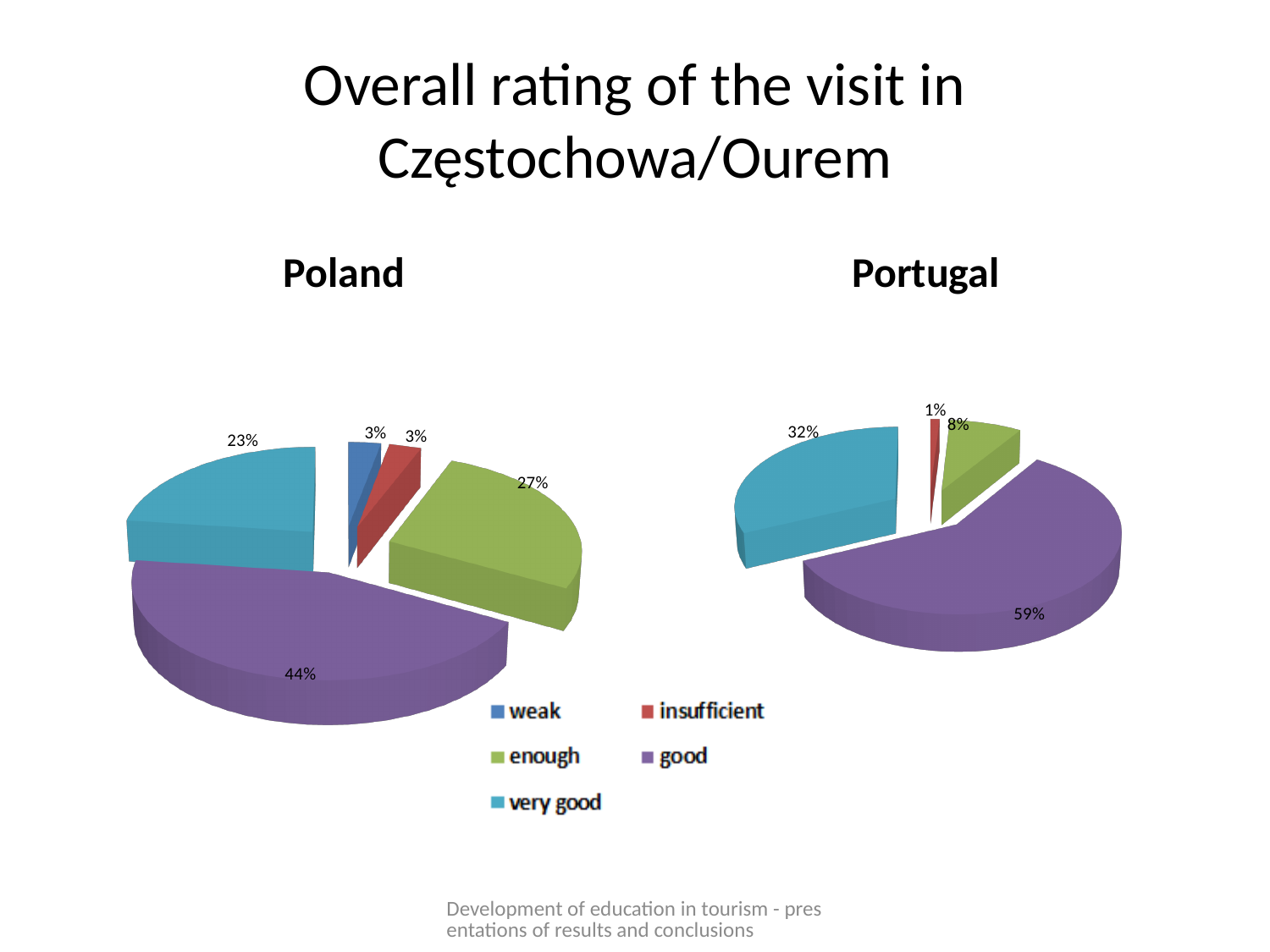
In the Portugal chart, what percentage is shown for the insufficient rating? 1% What type of chart is used for the Poland and Portugal data? pie chart In the Poland chart, what percentage is shown for the enough rating? 27% What is the difference between the good share in the Portugal chart and the good share in the Poland chart? 15% In the Portugal chart, what share of respondents rated the visit as very good? 32% How many rating categories does the legend list? 5 In the Poland chart, which rating has the largest share? good Which is larger: the very good share in the Poland chart or the very good share in the Portugal chart? Portugal How many slices are labelled in the Poland chart? 5 In the Portugal chart, which rating has the smallest share? insufficient In the Poland chart, what share of respondents rated the visit as good? 44% In the Portugal chart, which rating has the largest share? good